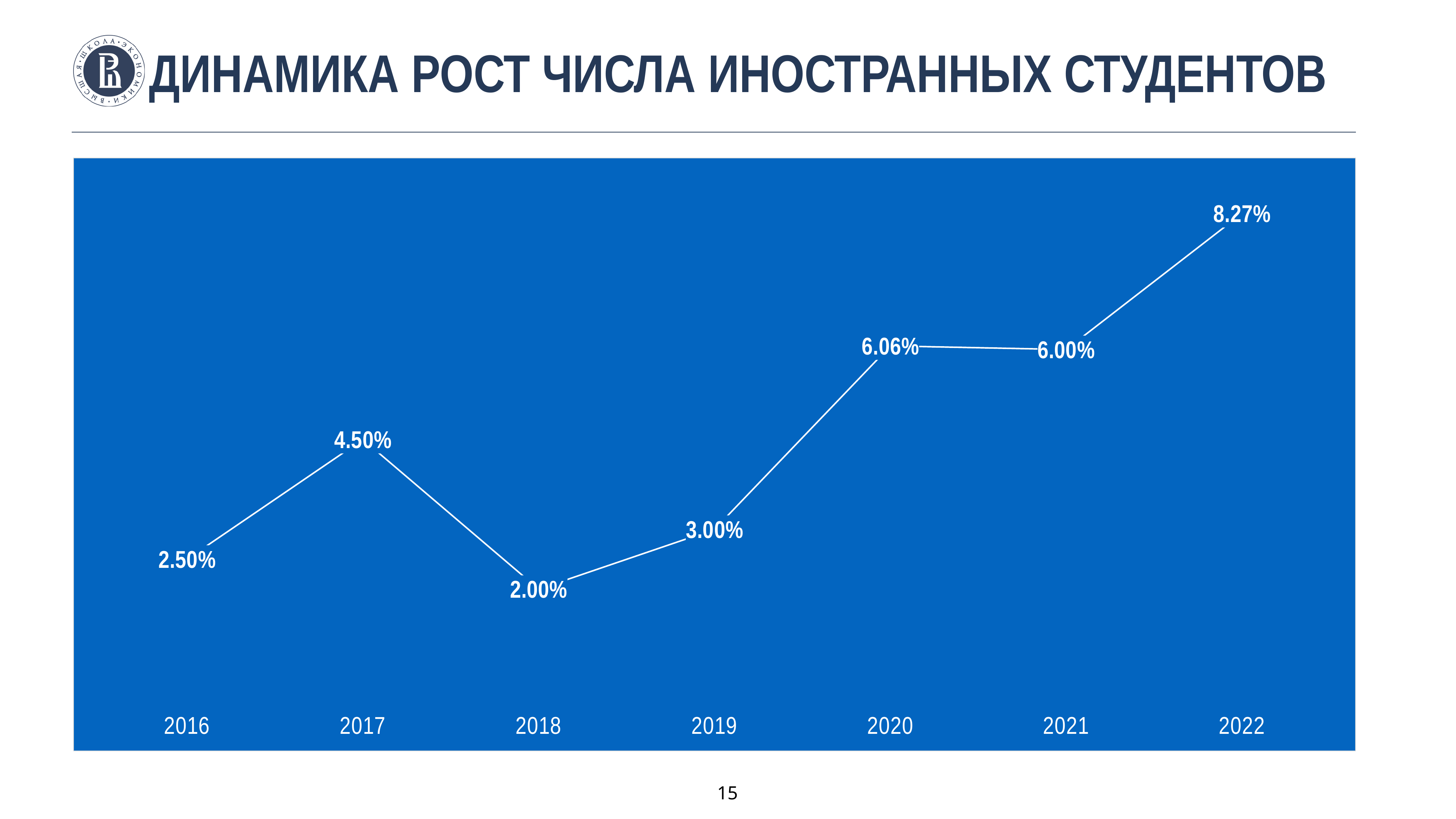
What is the value for 2020? 6.06% What is the title of the slide? ДИНАМИКА РОСТ ЧИСЛА ИНОСТРАННЫХ СТУДЕНТОВ What is the difference between the values for 2017 and 2018? 2.50% What is the value for 2022? 8.27% Which is larger, the value for 2017 or the value for 2019? 2017 What is the difference between the values for 2022 and 2021? 2.27% Which year has the highest value? 2022 How many years are plotted on the chart? 7 Which year has the lowest value? 2018 What kind of chart is shown on the slide? line chart Does the value rise or fall from 2019 to 2020? rise What is the value for 2016? 2.50%